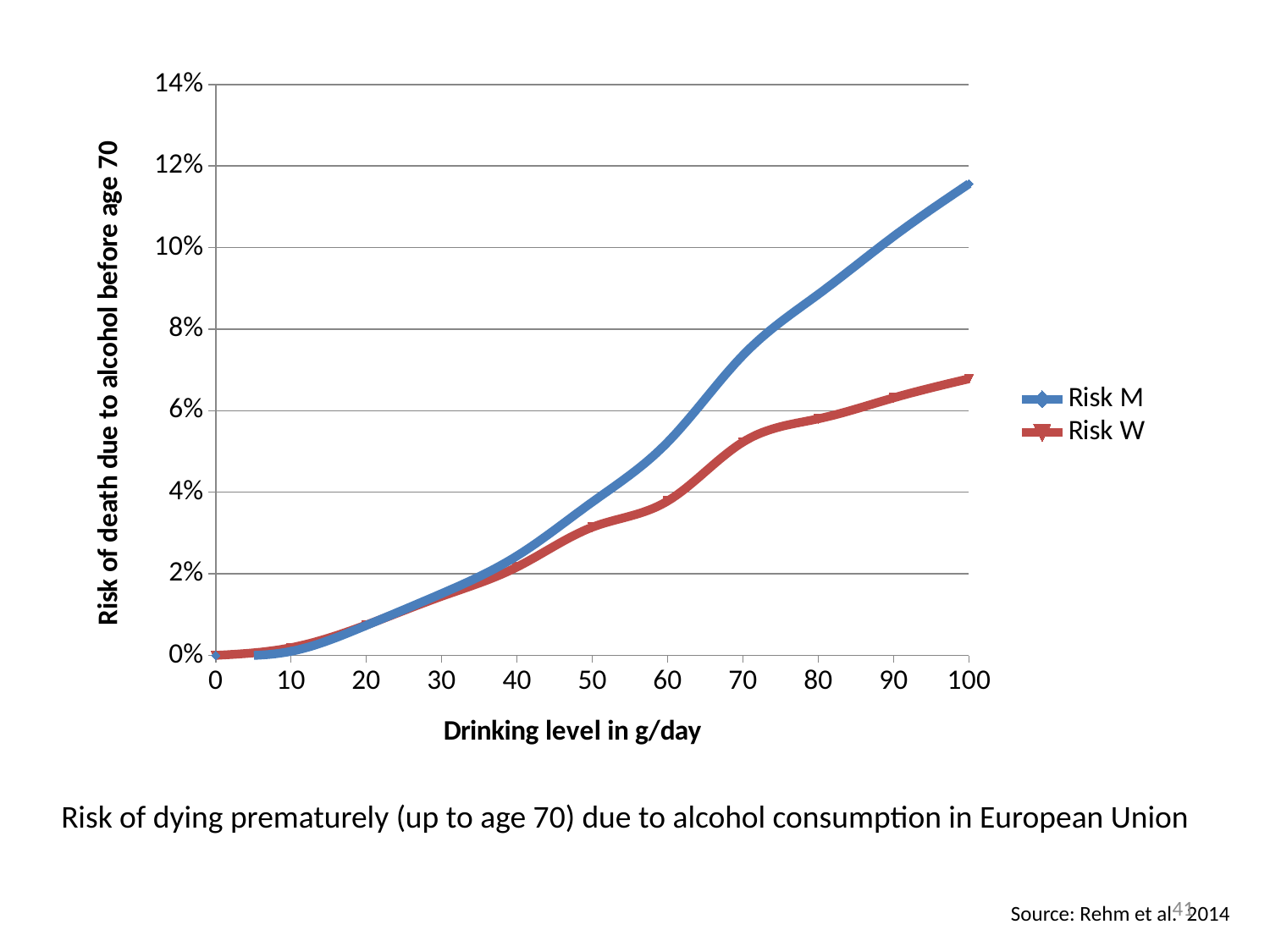
At a drinking level of 100 g/day, which series has the higher value, Risk M or Risk W? Risk M Is the value for Risk W at a drinking level of 50 g/day greater or less than 2%? greater Is the value for Risk W at a drinking level of 70 g/day greater or less than 6%? less Is the value for Risk M at a drinking level of 80 g/day greater or less than 8%? greater How many series does the legend list? 2 Do the values for Risk M rise or fall as the drinking level increases along the x axis? rise At a drinking level of 60 g/day, which series has the lower value, Risk M or Risk W? Risk W What kind of chart is shown on the slide? line chart What is the title of the x axis? Drinking level in g/day What are the two series named in the legend? Risk M and Risk W